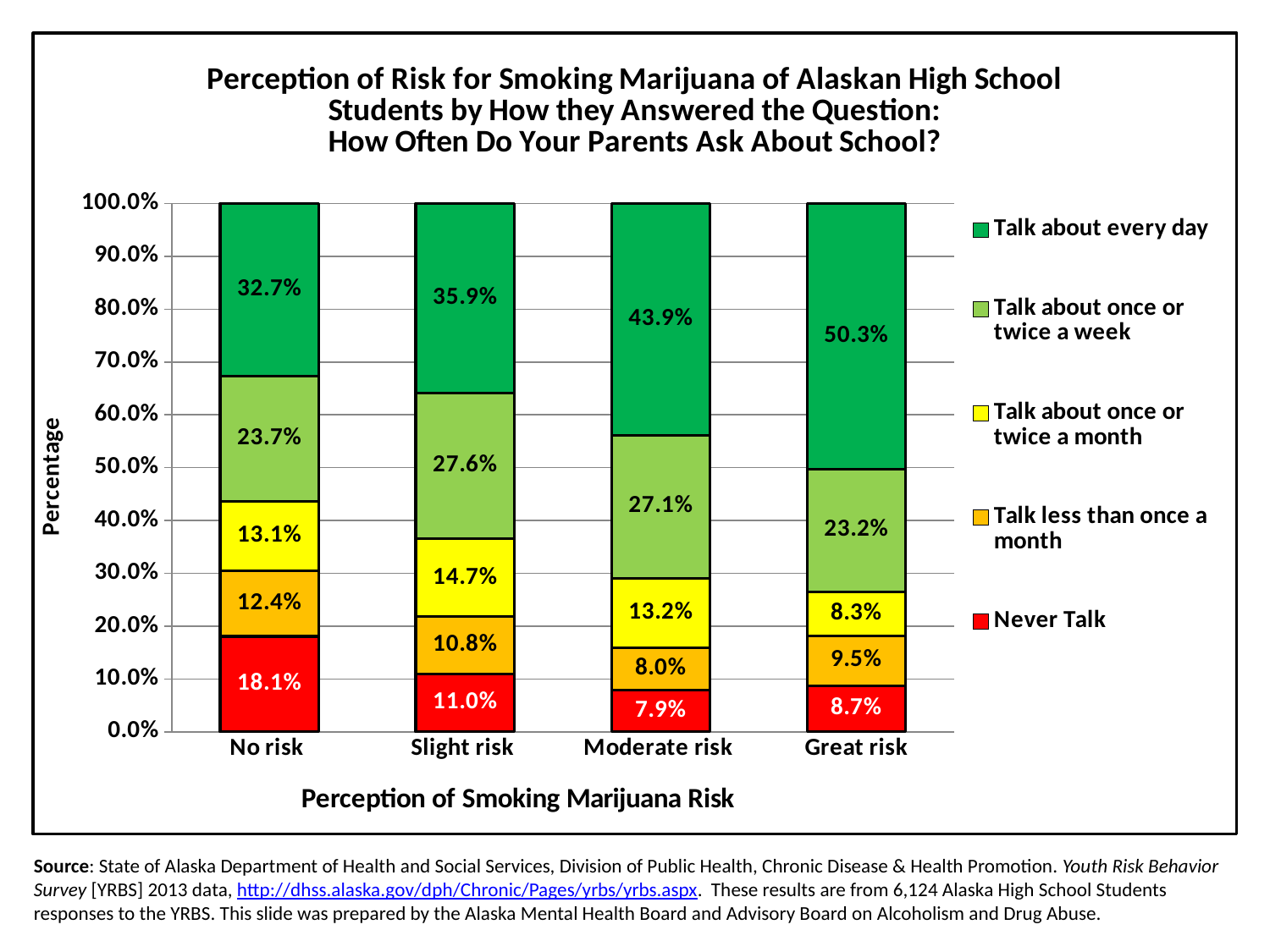
Which risk perception category has the highest value for 'Talk about every day'? Great risk What percentage of students who perceive no risk from smoking marijuana report that their parents talk about school every day? 32.7% What is the value for 'Never Talk' in the Great risk category? 8.7% Which colour represents the 'Never Talk' series? Red What is the difference between the 'Talk about every day' values for Great risk and No risk? 17.6% Which risk perception category has the lowest value for 'Never Talk'? Moderate risk Do the 'Talk about every day' values rise or fall moving from No risk to Great risk along the x axis? Rise How many series does the legend list? 5 How many risk perception categories are shown on the x axis? 4 Which is larger: the 'Talk less than once a month' value for No risk or for Great risk? No risk What is the value for 'Talk about once or twice a month' in the Slight risk category? 14.7% What kind of chart is shown on the slide? Stacked bar chart